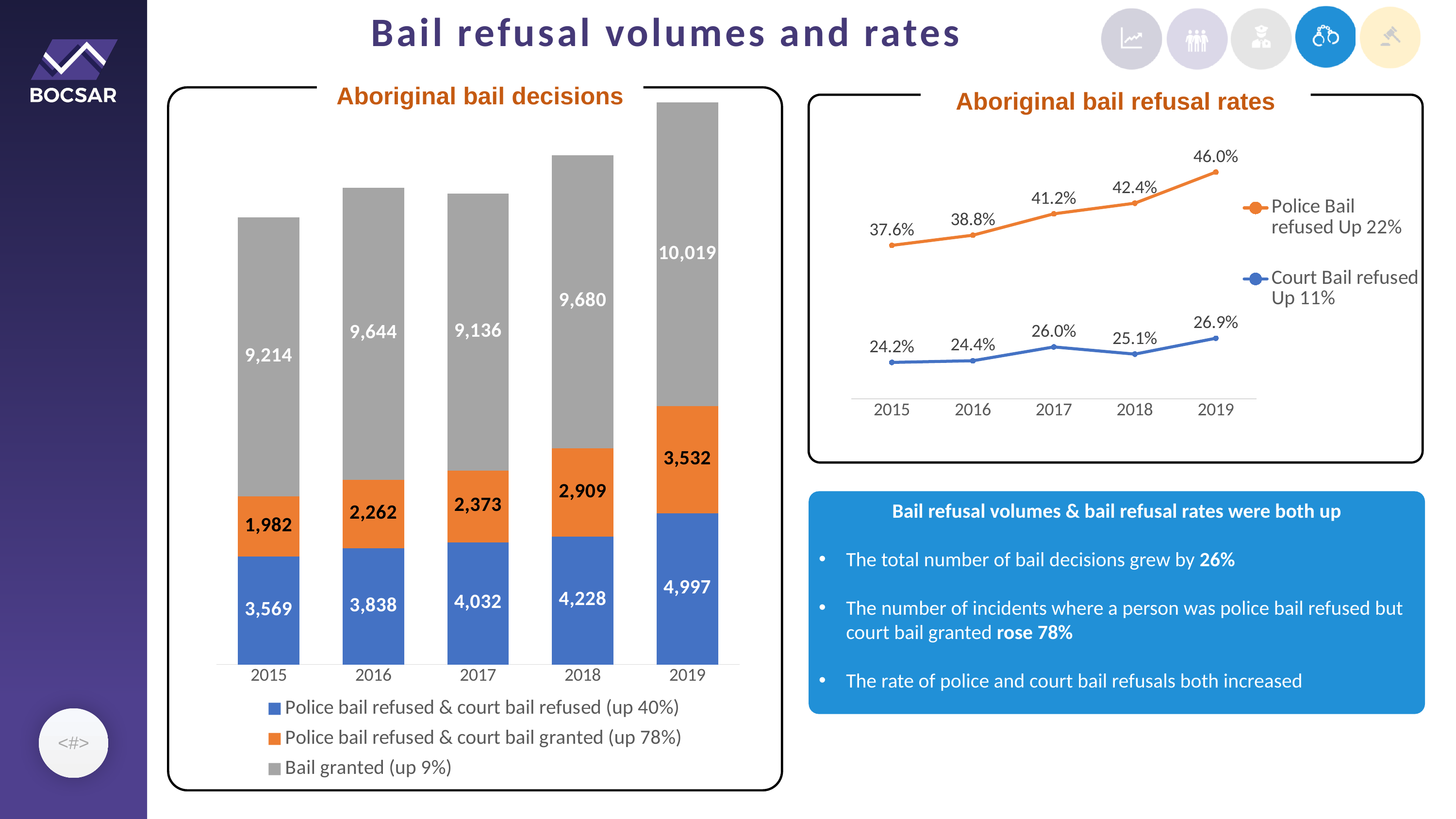
In the 'Aboriginal bail decisions' chart, which year has the highest value for 'Police bail refused & court bail refused'? 2019 In the 'Aboriginal bail decisions' chart, what is the value for 'Bail granted' in 2019? 10,019 In the 'Aboriginal bail decisions' chart, how many series does the legend list? 3 In the 'Aboriginal bail refusal rates' chart, what is the difference between the 'Police Bail refused' rate and the 'Court Bail refused' rate in 2019? 19.1% In the 'Aboriginal bail decisions' chart, which year has the lowest value for 'Bail granted'? 2017 In the 'Aboriginal bail refusal rates' chart, what is the 'Police Bail refused' rate in 2018? 42.4% In the 'Aboriginal bail refusal rates' chart, which year has the lowest 'Court Bail refused' rate? 2015 In the 'Aboriginal bail decisions' chart, what is the value for 'Police bail refused & court bail granted' in 2017? 2,373 In the 'Aboriginal bail refusal rates' chart, how many years are plotted on the x axis? 5 In the 'Aboriginal bail decisions' chart, what is the difference between the 'Police bail refused & court bail refused' values for 2019 and 2015? 1,428 In the 'Aboriginal bail decisions' chart, what is the total of the stacked bar for 2015? 14,765 What kind of chart is the 'Aboriginal bail decisions' chart? Stacked bar chart